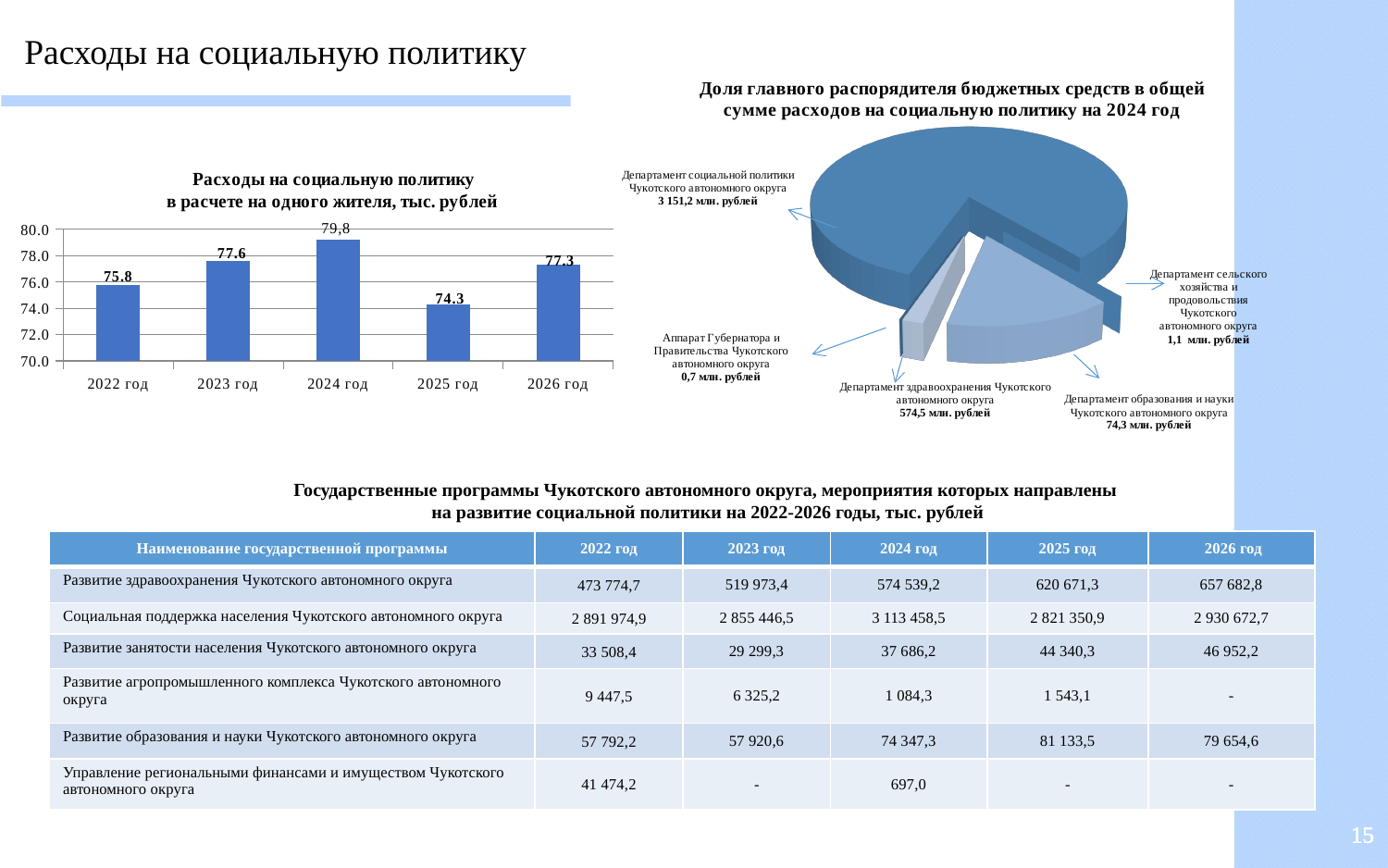
What kind of chart is 'Доля главного распорядителя бюджетных средств в общей сумме расходов на социальную политику на 2024 год'? pie chart In the bar chart 'Расходы на социальную политику в расчете на одного жителя, тыс. рублей', how many years are shown on the x axis? 5 In the bar chart 'Расходы на социальную политику в расчете на одного жителя, тыс. рублей', what is the difference between the values for 2023 год and 2022 год? 1.8 What kind of chart is 'Расходы на социальную политику в расчете на одного жителя, тыс. рублей'? bar chart In the bar chart 'Расходы на социальную политику в расчете на одного жителя, тыс. рублей', which year has the highest value? 2024 год In the bar chart 'Расходы на социальную политику в расчете на одного жителя, тыс. рублей', which year has the lowest value? 2025 год In the bar chart 'Расходы на социальную политику в расчете на одного жителя, тыс. рублей', which is larger: the value for 2023 год or 2026 год? 2023 год In the pie chart 'Доля главного распорядителя бюджетных средств в общей сумме расходов на социальную политику на 2024 год', which has the smallest value? Аппарат Губернатора и Правительства Чукотского автономного округа In the bar chart 'Расходы на социальную политику в расчете на одного жителя, тыс. рублей', what is the value for 2022 год? 75.8 In the bar chart 'Расходы на социальную политику в расчете на одного жителя, тыс. рублей', what is the value for 2025 год? 74.3 In the pie chart 'Доля главного распорядителя бюджетных средств в общей сумме расходов на социальную политику на 2024 год', which department has the largest value? Департамент социальной политики Чукотского автономного округа In the pie chart 'Доля главного распорядителя бюджетных средств в общей сумме расходов на социальную политику на 2024 год', what is the value for Департамент здравоохранения Чукотского автономного округа? 574,5 млн. рублей